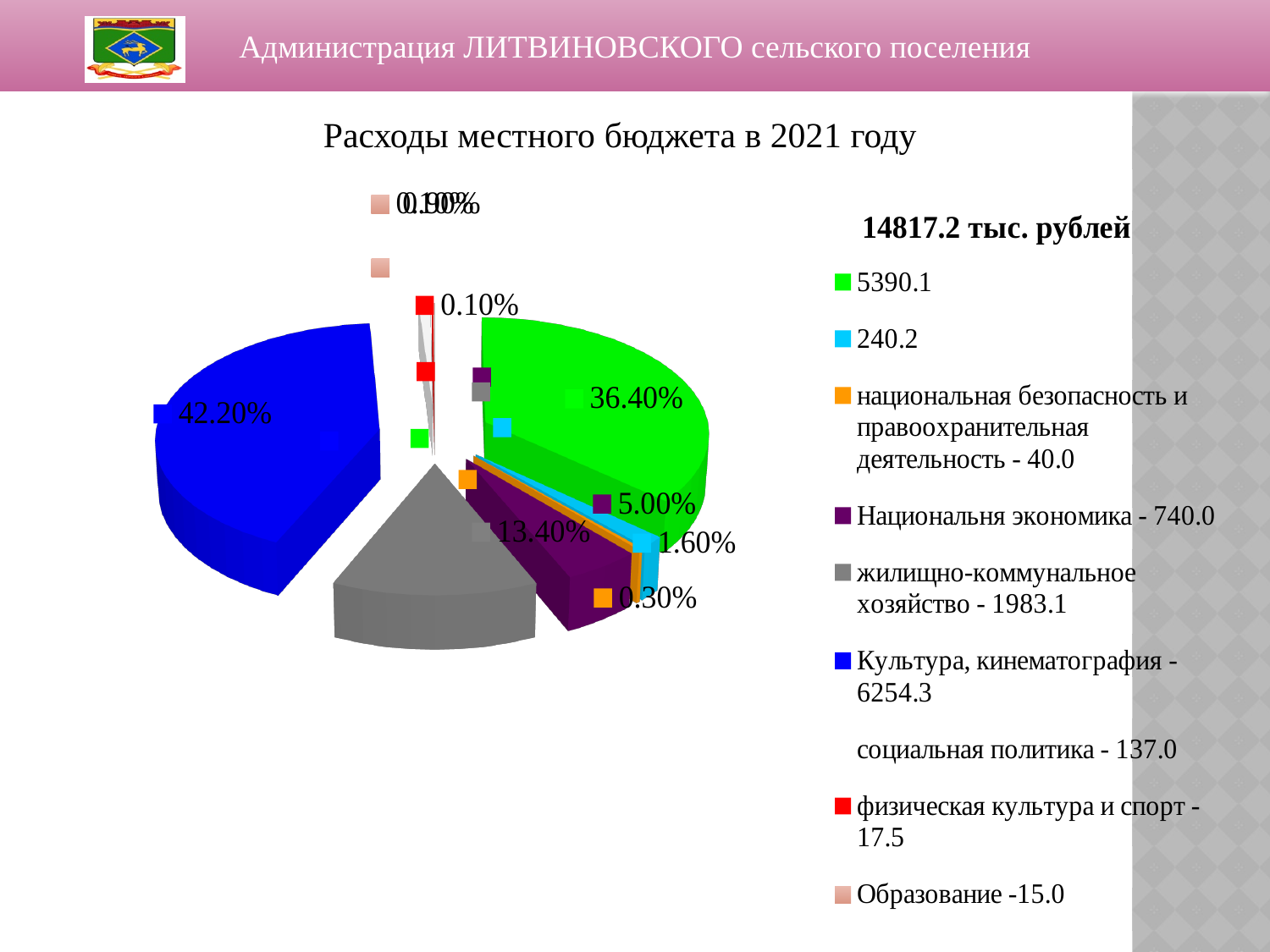
How many entries does the legend list? 9 What is the title of the chart? 14817.2 тыс. рублей What percentage share is shown for the национальная безопасность и правоохранительная деятельность slice? 0.30% Which category has the largest slice of the pie? Культура, кинематография What percentage share is shown for the физическая культура и спорт slice? 0.10% What percentage share is shown for the жилищно-коммунальное хозяйство slice? 13.40% What kind of chart is shown on the slide? Pie chart Which slice is larger: the green slice (36.40%) or the grey жилищно-коммунальное хозяйство slice? The green slice (36.40%) What total amount is stated above the legend? 14817.2 тыс. рублей What is the difference in percentage points between the 42.20% slice and the 36.40% slice? 5.80%